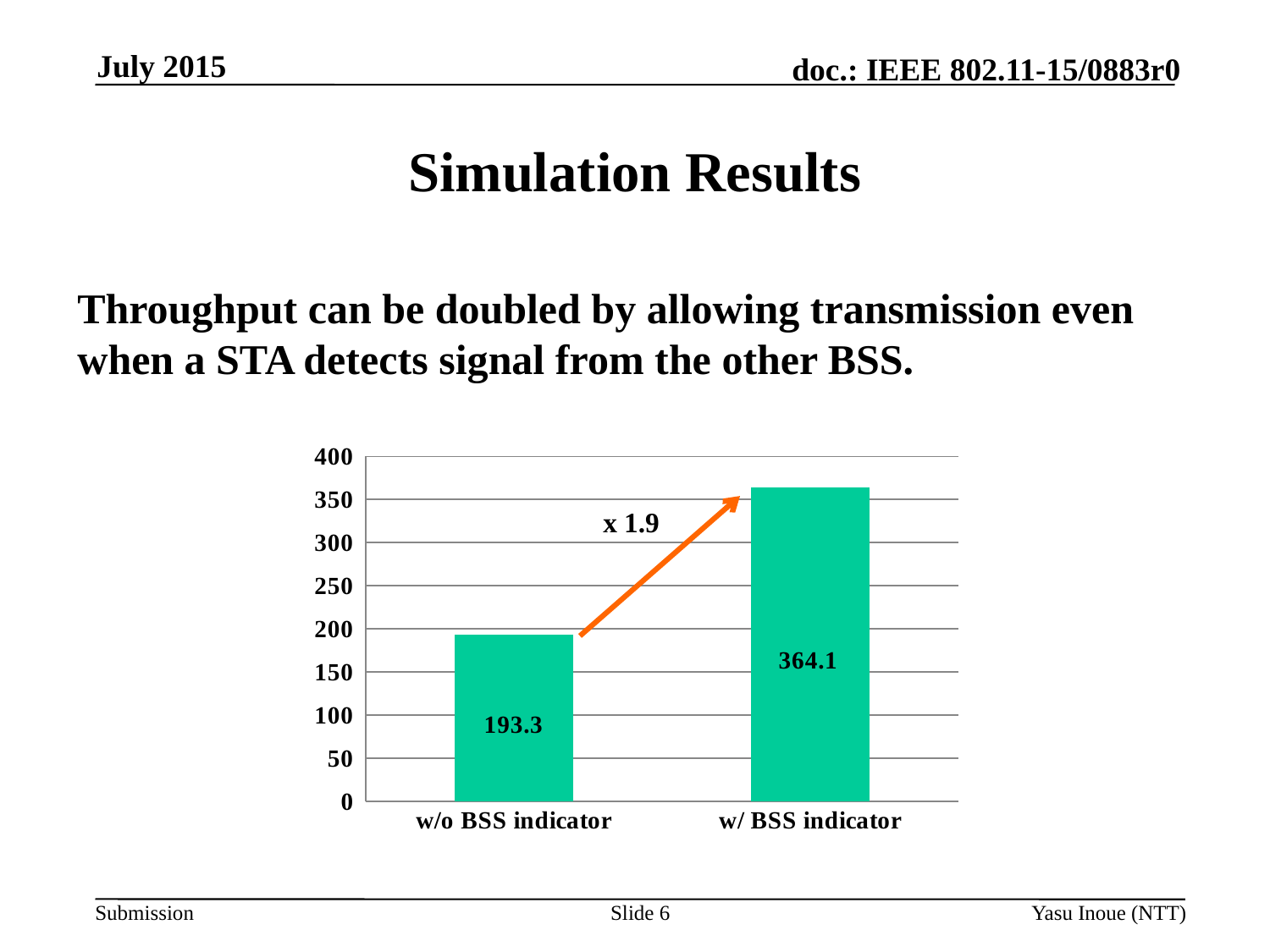
What is the difference between the values for w/ BSS indicator and w/o BSS indicator? 170.8 Which category has the lowest value? w/o BSS indicator What multiplier is annotated on the arrow between the two bars? x 1.9 What is the value for w/o BSS indicator? 193.3 What is the value for w/ BSS indicator? 364.1 Which category has the highest value? w/ BSS indicator Is the value for w/o BSS indicator greater or less than 200? less What kind of chart is shown on the slide? bar chart Is the value for w/ BSS indicator greater or less than 350? greater Which is larger, the value for w/o BSS indicator or the value for w/ BSS indicator? w/ BSS indicator What is the maximum value shown on the y axis? 400 How many categories are shown on the x axis? 2